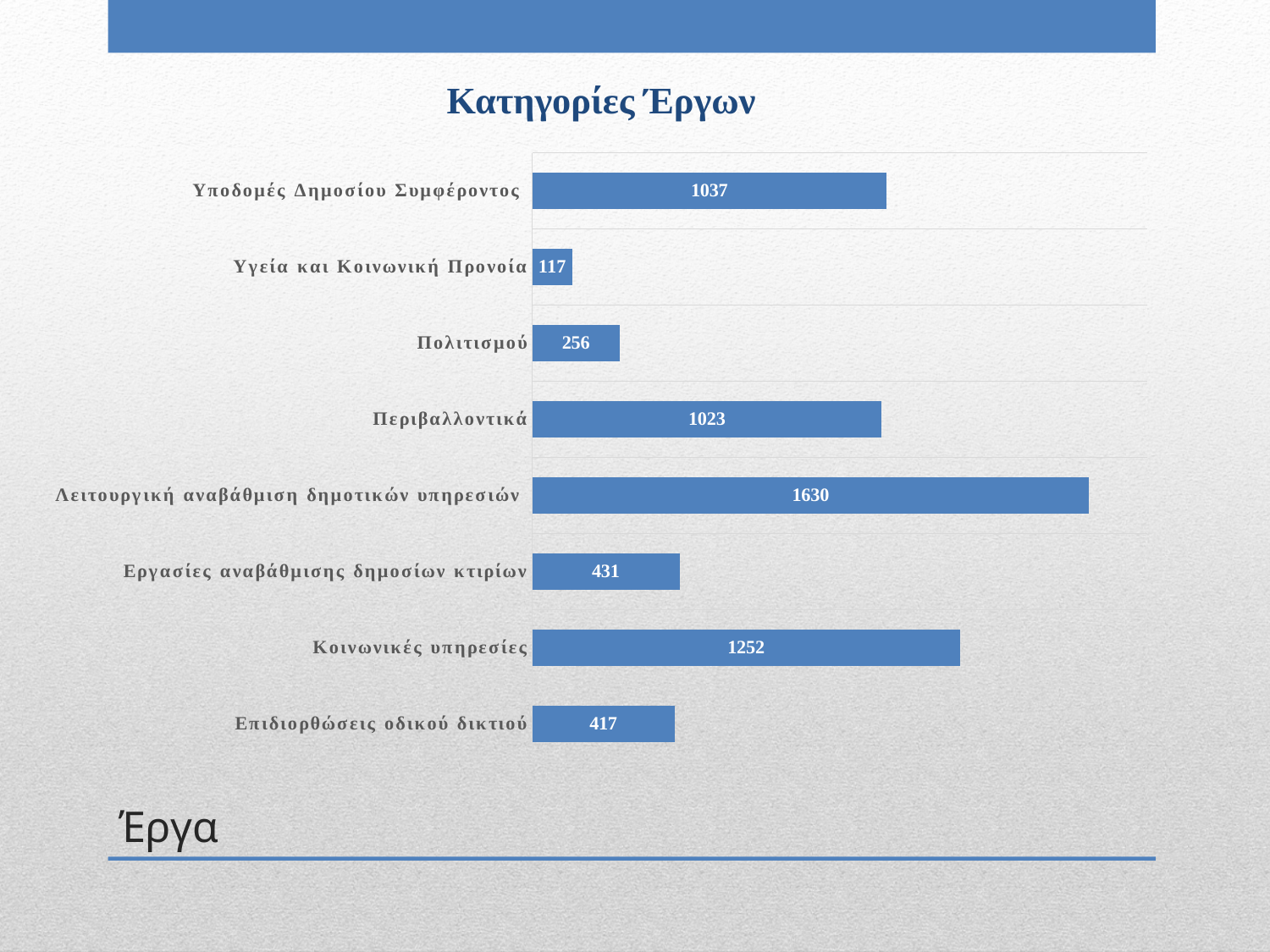
What is the difference between the values for Υποδομές Δημοσίου Συμφέροντος and Περιβαλλοντικά? 14 Which is larger, the value for Κοινωνικές υπηρεσίες or the value for Υποδομές Δημοσίου Συμφέροντος? Κοινωνικές υπηρεσίες How many categories are shown in the chart? 8 What kind of chart is shown on the slide? Bar chart Which category has the lowest value? Υγεία και Κοινωνική Προνοία What is the title of the chart? Κατηγορίες Έργων What is the value for Υγεία και Κοινωνική Προνοία? 117 What is the value for Λειτουργική αναβάθμιση δημοτικών υπηρεσιών? 1630 Which category has the highest value? Λειτουργική αναβάθμιση δημοτικών υπηρεσιών What is the difference between the values for Εργασίες αναβάθμισης δημοσίων κτιρίων and Επιδιορθώσεις οδικού δικτιού? 14 What is the value for Κοινωνικές υπηρεσίες? 1252 Which is larger, the value for Πολιτισμού or the value for Επιδιορθώσεις οδικού δικτιού? Επιδιορθώσεις οδικού δικτιού